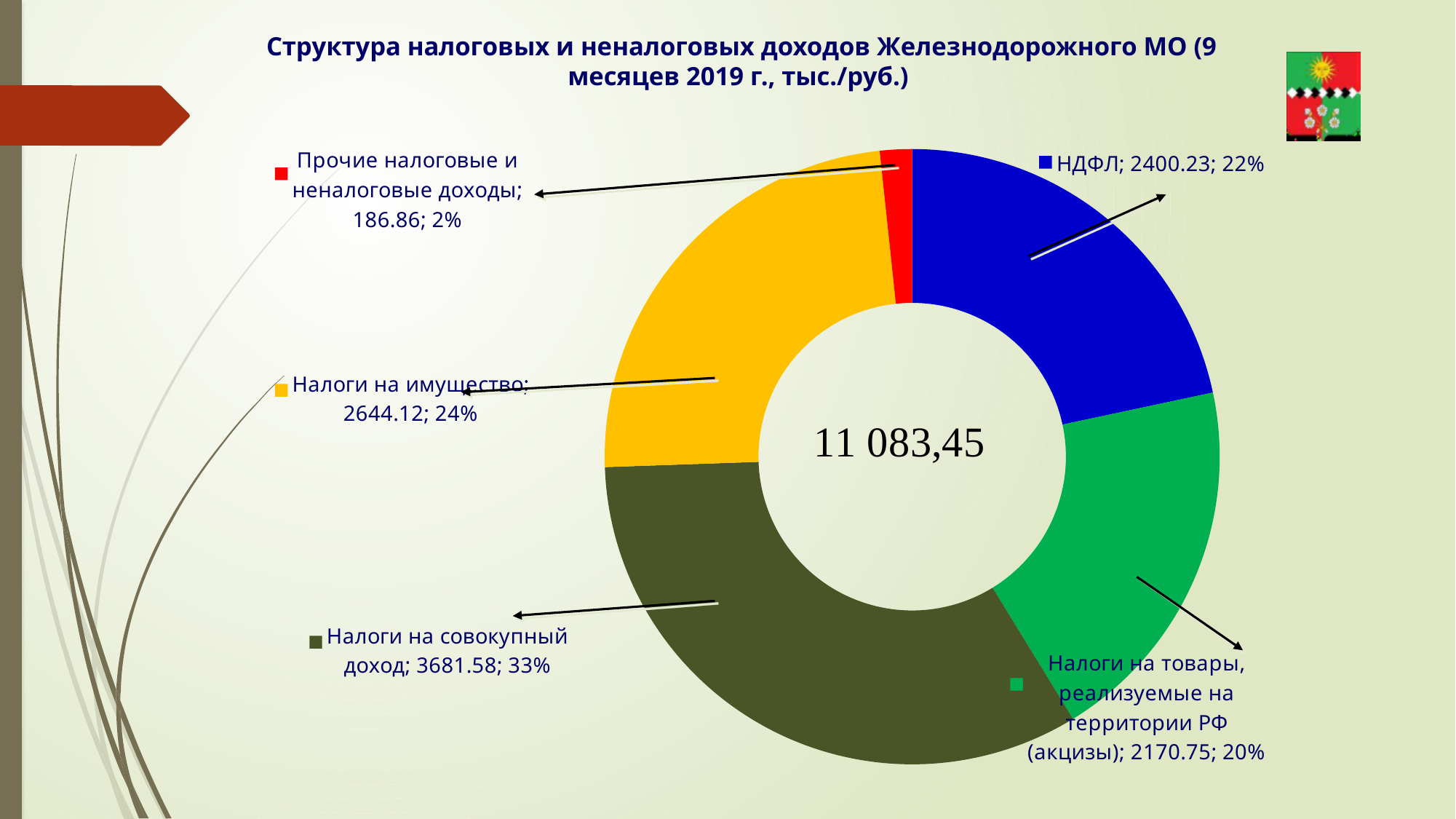
What kind of chart is shown on the slide? doughnut chart Which is larger: НДФЛ or Налоги на товары, реализуемые на территории РФ (акцизы)? НДФЛ What is the difference between Налоги на совокупный доход and Налоги на имущество? 1037.46 What share of the chart does Налоги на товары, реализуемые на территории РФ (акцизы) represent? 20% What is the value for Налоги на совокупный доход? 3681.58 What is the value for НДФЛ? 2400.23 What total value is printed in the centre of the chart? 11 083,45 How many categories does the chart show? 5 What is the value for Прочие налоговые и неналоговые доходы? 186.86 Which category has the largest value? Налоги на совокупный доход Which category has the smallest value? Прочие налоговые и неналоговые доходы What is the value for Налоги на имущество? 2644.12